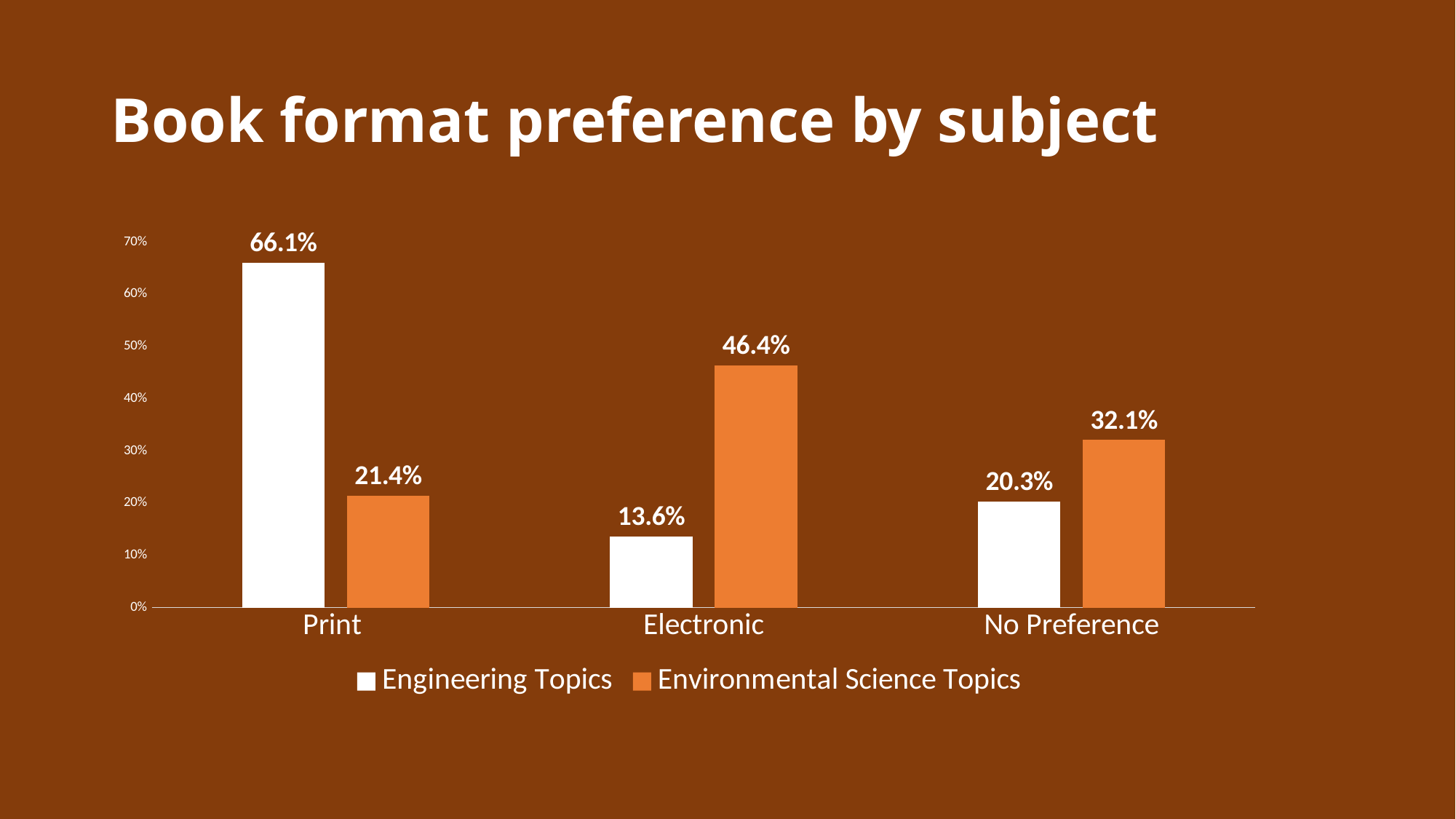
What is the value for Engineering Topics in the No Preference category? 20.3% What is the value for Engineering Topics in the Print category? 66.1% In the Electronic category, which series has the larger value? Environmental Science Topics What kind of chart is shown on the slide? Bar chart Which category has the highest value for Engineering Topics? Print How many series does the legend list? 2 What is the title of the chart? Book format preference by subject How many categories are shown on the x axis? 3 What is the value for Environmental Science Topics in the Electronic category? 46.4% What is the difference between Engineering Topics and Environmental Science Topics in the Print category? 44.7% Which category has the lowest value for Environmental Science Topics? Print Is the value for Environmental Science Topics in the No Preference category greater or less than 30%? greater